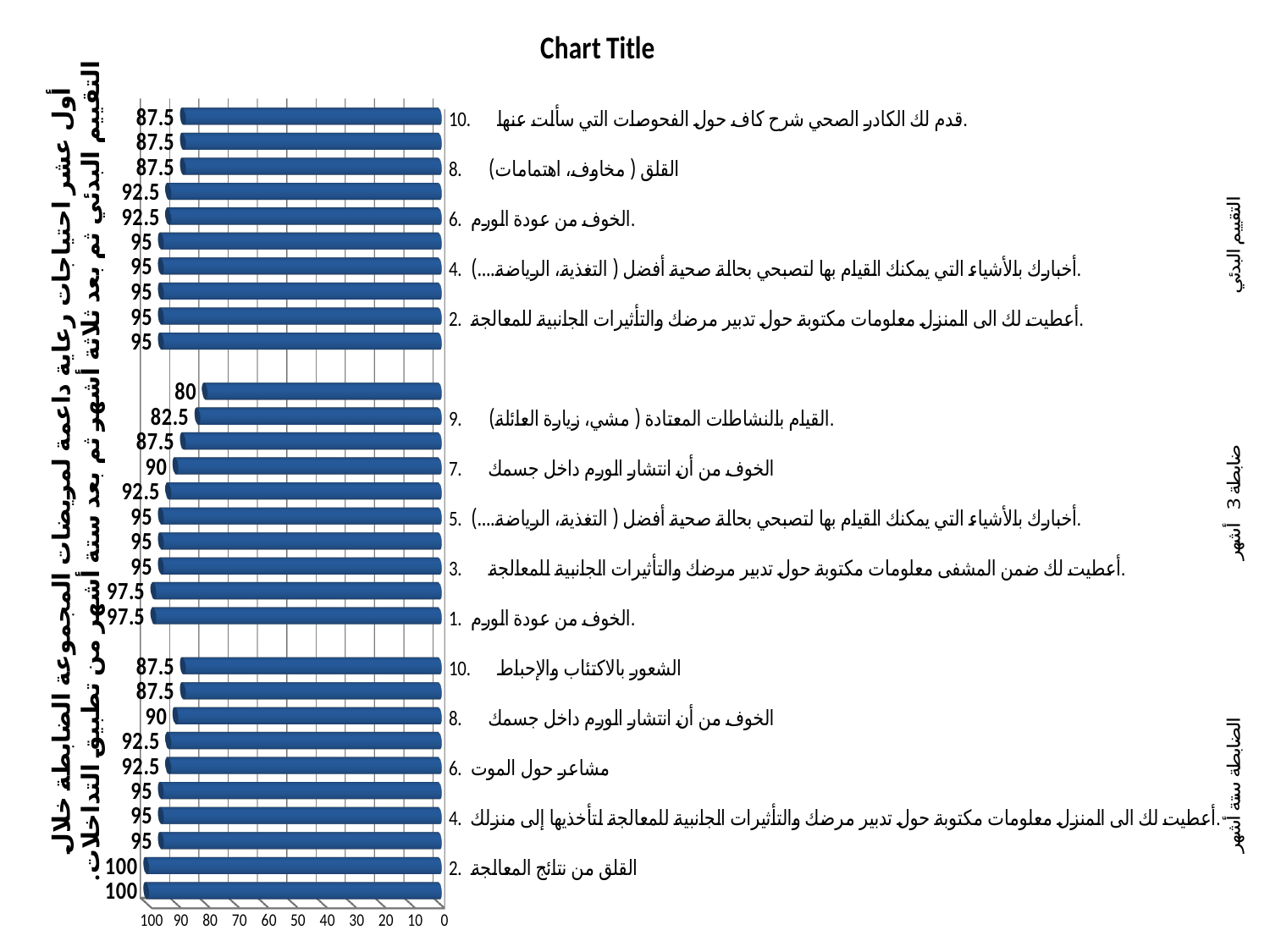
In the 'ضابطة 3 أشهر' group, what is the value for '1. الخوف من عودة الورم'? 97.5 In the 'الضابطة ستة أشهر' group, what is the value for '2. القلق من نتائج المعالجة'? 100 In the 'التقييم البدئي' group, what is the value for '8. القلق (مخاوف، اهتمامات)'? 87.5 What type of chart is shown on the slide? bar chart What is the lowest value shown on the chart? 80 In the 'ضابطة 3 أشهر' group, what is the value for '9. القيام بالنشاطات المعتادة (مشي، زيارة العائلة)'? 82.5 What is the highest value shown on the chart? 100 What is the title of the chart? Chart Title In the 'الضابطة ستة أشهر' group, what is the value for '6. مشاعر حول الموت'? 92.5 In the 'ضابطة 3 أشهر' group, what is the difference between the value for '1. الخوف من عودة الورم' and the value for '9. القيام بالنشاطات المعتادة'? 15 In the 'الضابطة ستة أشهر' group, which is larger: the value for '10. الشعور بالاكتئاب والإحباط' or the value for '8. الخوف من أن انتشار الورم داخل جسمك'? 8. الخوف من أن انتشار الورم داخل جسمك How many bars are plotted on the chart in total? 30